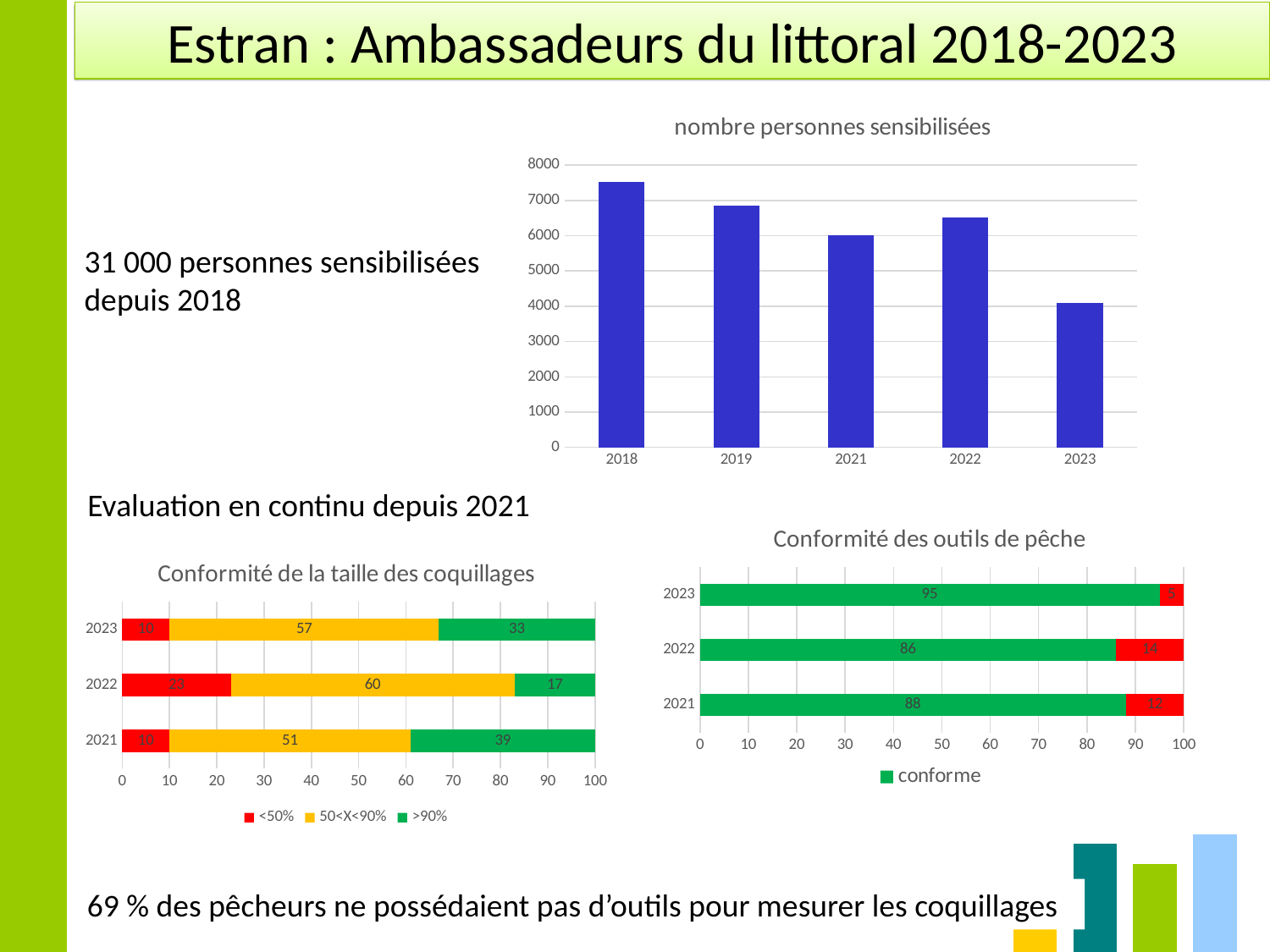
In the chart titled 'nombre personnes sensibilisées', which year has the lowest bar? 2023 In the chart titled 'nombre personnes sensibilisées', which year has the highest bar? 2018 In the chart titled 'Conformité de la taille des coquillages', what is the value of the '>90%' segment for 2021? 39 In the chart titled 'nombre personnes sensibilisées', is the value for 2023 greater or less than 5000? less In the chart titled 'Conformité des outils de pêche', which year has the highest 'conforme' value? 2023 In the chart titled 'Conformité de la taille des coquillages', what is the difference between the '<50%' values for 2022 and 2023? 13 What kind of chart is the one titled 'Conformité des outils de pêche'? Stacked bar chart In the chart titled 'Conformité des outils de pêche', what is the 'conforme' value for 2022? 86 In the chart titled 'nombre personnes sensibilisées', how many years are shown on the x axis? 5 In the chart titled 'Conformité de la taille des coquillages', how many series does the legend list? 3 In the chart titled 'nombre personnes sensibilisées', is the value for 2018 greater or less than 7000? greater In the chart titled 'Conformité de la taille des coquillages', what is the value of the '50<X<90%' segment for 2022? 60